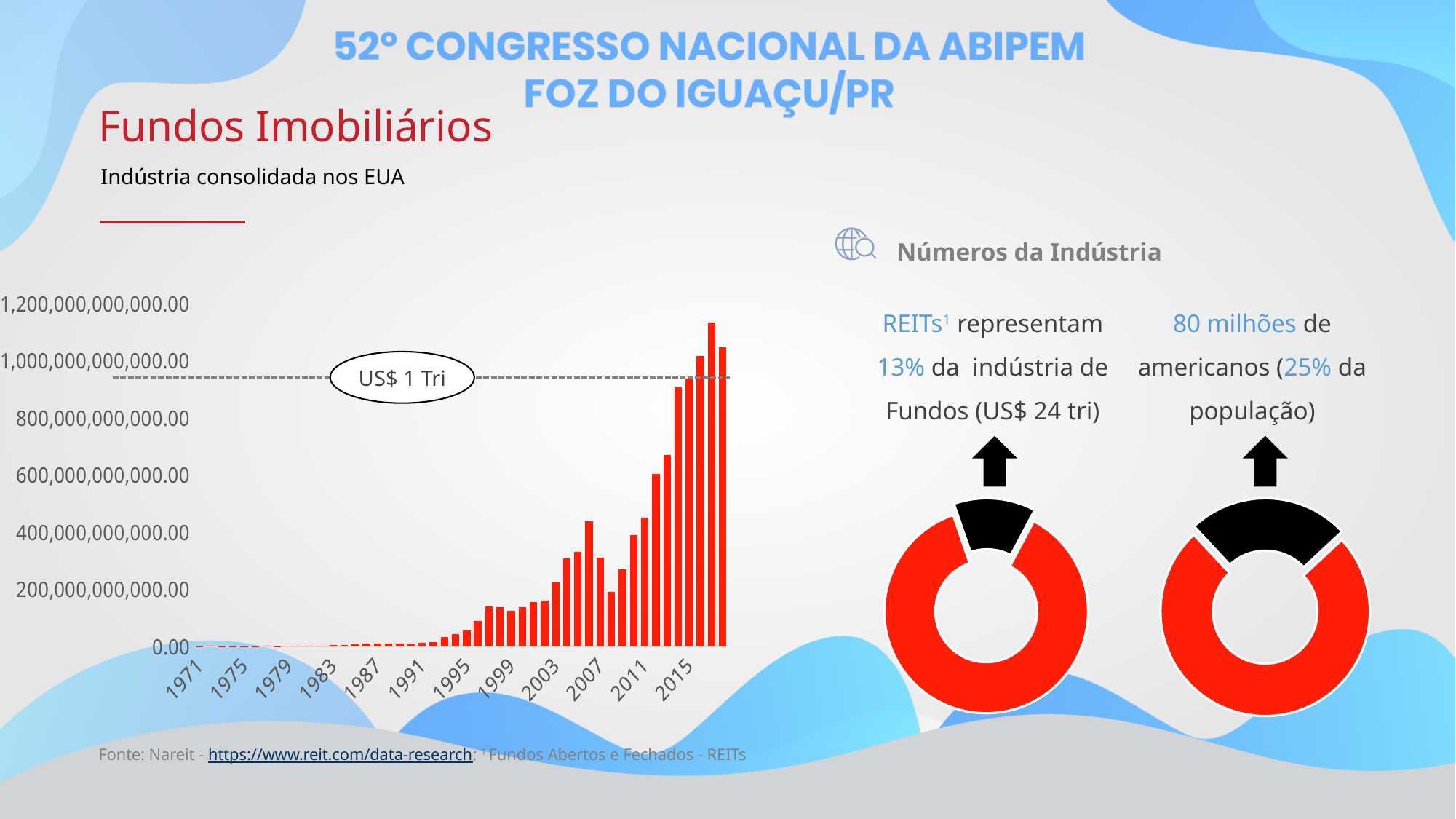
What label is shown on the dashed horizontal line in the bar chart? US$ 1 Tri In the bar chart, is the value for 1999 greater or less than 200,000,000,000.00? less In the bar chart, is the value for 2011 greater or less than 600,000,000,000.00? less In the bar chart, is the value for 2015 greater or less than 800,000,000,000.00? greater What is the highest tick value shown on the y axis of the bar chart? 1,200,000,000,000.00 In the bar chart, which is larger, the value for 2011 or the value for 2015? 2015 In the bar chart, do the values generally rise or fall from 1971 to 2015? rise How many year labels are shown on the x axis of the bar chart? 12 What kind of chart is shown on the left side of the slide? bar chart In the left donut chart under 'Números da Indústria', what share of the fund industry do REITs represent? 13% In the right donut chart under 'Números da Indústria', what share of the population do the 80 million Americans represent? 25%